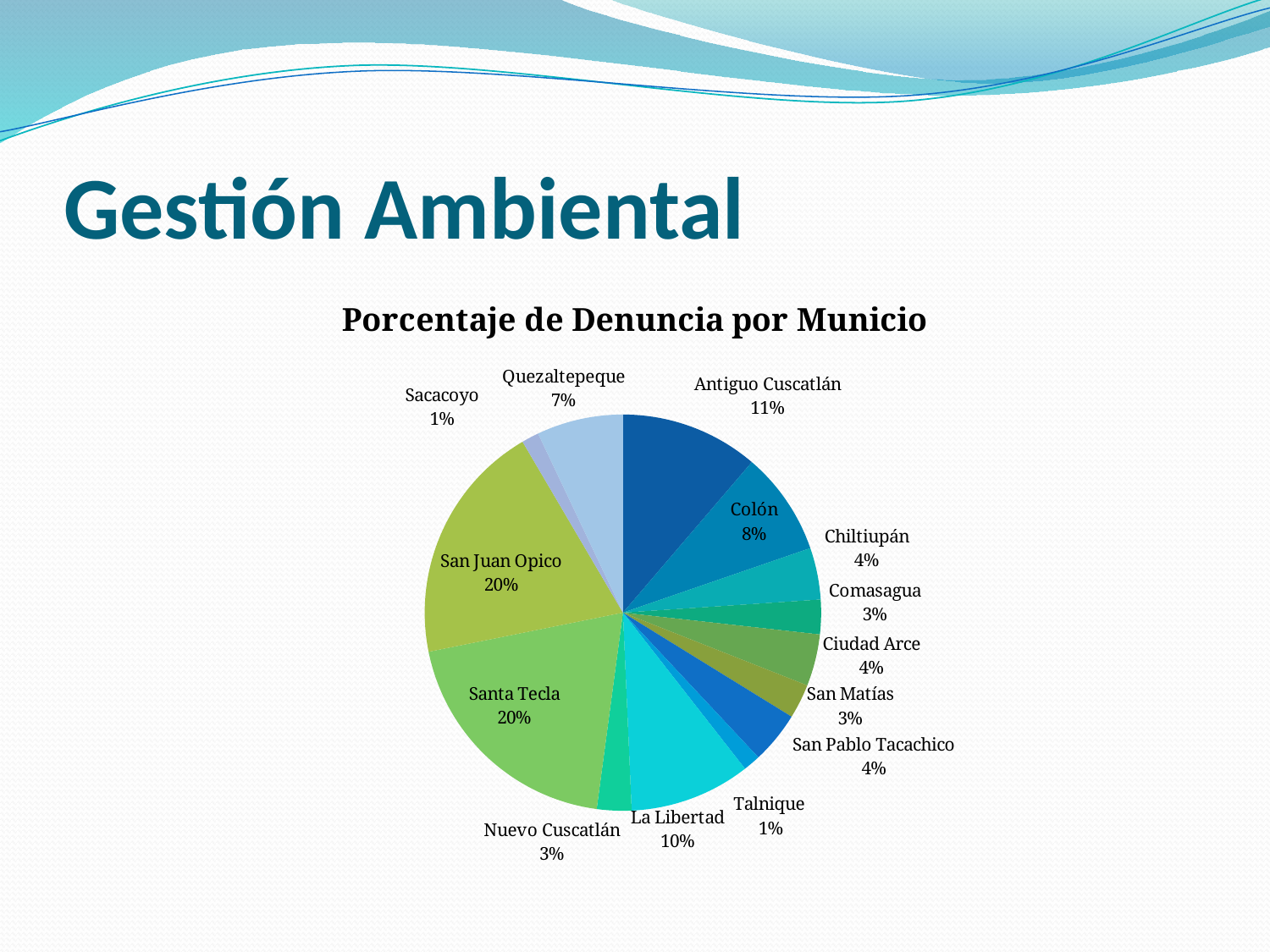
Which is larger, the share for Santa Tecla or the share for La Libertad? Santa Tecla What is the value shown for Quezaltepeque? 7% What is the value shown for Colón? 8% What is the title of the chart? Porcentaje de Denuncia por Municio What is the difference in percentage points between Santa Tecla and Quezaltepeque? 13 What type of chart is shown on the slide? pie chart What is the difference in percentage points between Antiguo Cuscatlán and Chiltiupán? 7 How many municipalities (slices) are shown in the pie chart? 14 Which is larger, the share for Antiguo Cuscatlán or the share for Colón? Antiguo Cuscatlán What percentage of the pie does Antiguo Cuscatlán represent? 11% What is the value shown for San Pablo Tacachico? 4% What is the value shown for La Libertad? 10%